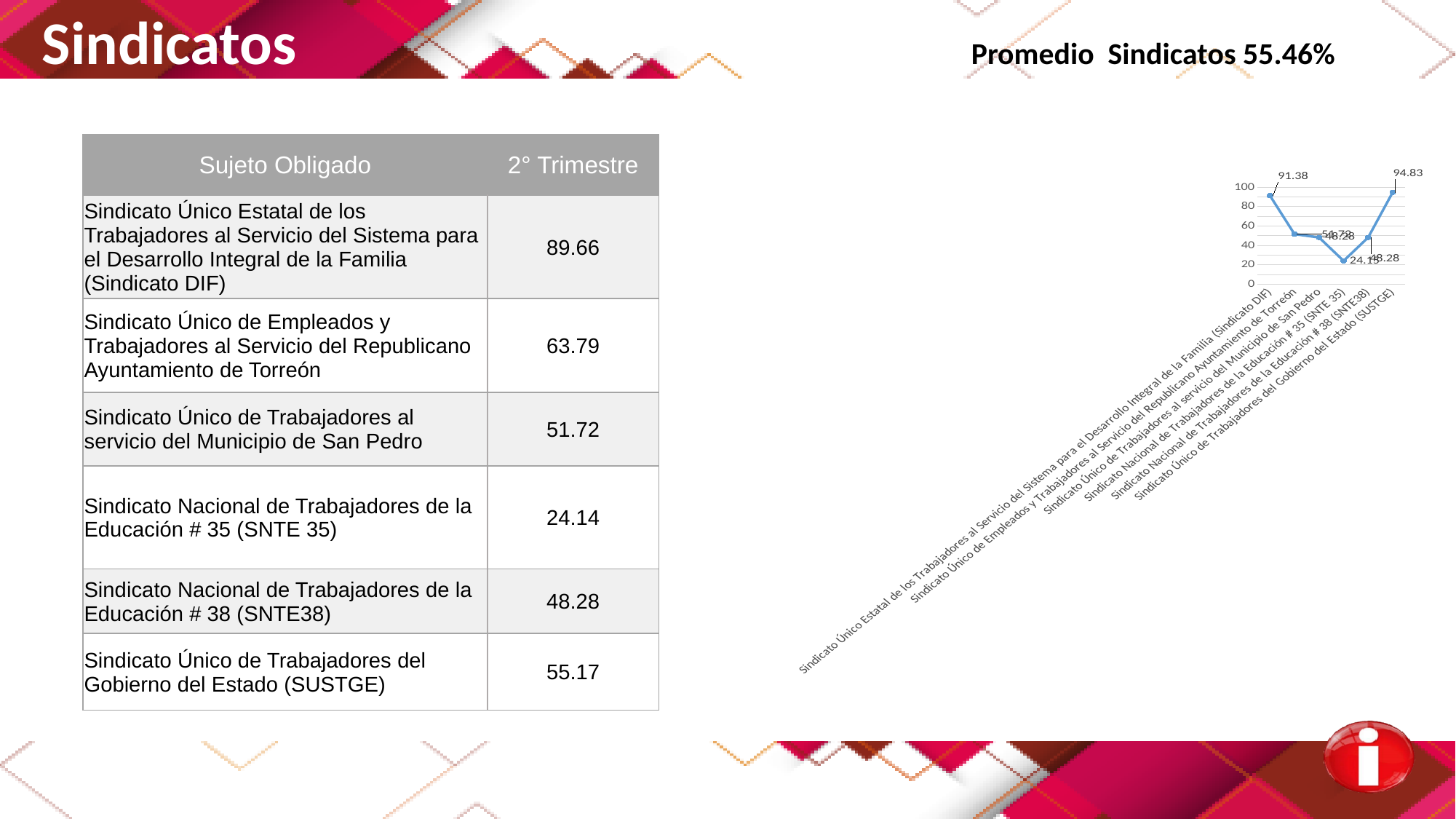
In the line chart, what is the value for Sindicato Único Estatal de los Trabajadores al Servicio del Sistema para el Desarrollo Integral de la Familia (Sindicato DIF)? 91.38 In the line chart, is the value for Sindicato Único de Empleados y Trabajadores al Servicio del Republicano Ayuntamiento de Torreón greater or less than 80? less In the line chart, what is the value for Sindicato Único de Trabajadores del Gobierno del Estado (SUSTGE)? 94.83 In the line chart, which category has the lowest value? Sindicato Nacional de Trabajadores de la Educación # 35 (SNTE 35) How many data points are plotted in the line chart? 6 What is the highest tick value shown on the vertical axis of the line chart? 100 In the line chart, which category has the highest value? Sindicato Único de Trabajadores del Gobierno del Estado (SUSTGE) In the line chart, what is the value for Sindicato Nacional de Trabajadores de la Educación # 35 (SNTE 35)? 24.15 In the line chart, which is larger: the value for SNTE38 or the value for SNTE 35? SNTE38 In the line chart, what is the value for Sindicato Nacional de Trabajadores de la Educación # 38 (SNTE38)? 48.28 What kind of chart is shown on the right of the slide? line chart In the line chart, what is the difference between the value for SUSTGE and the value for Sindicato DIF? 3.45